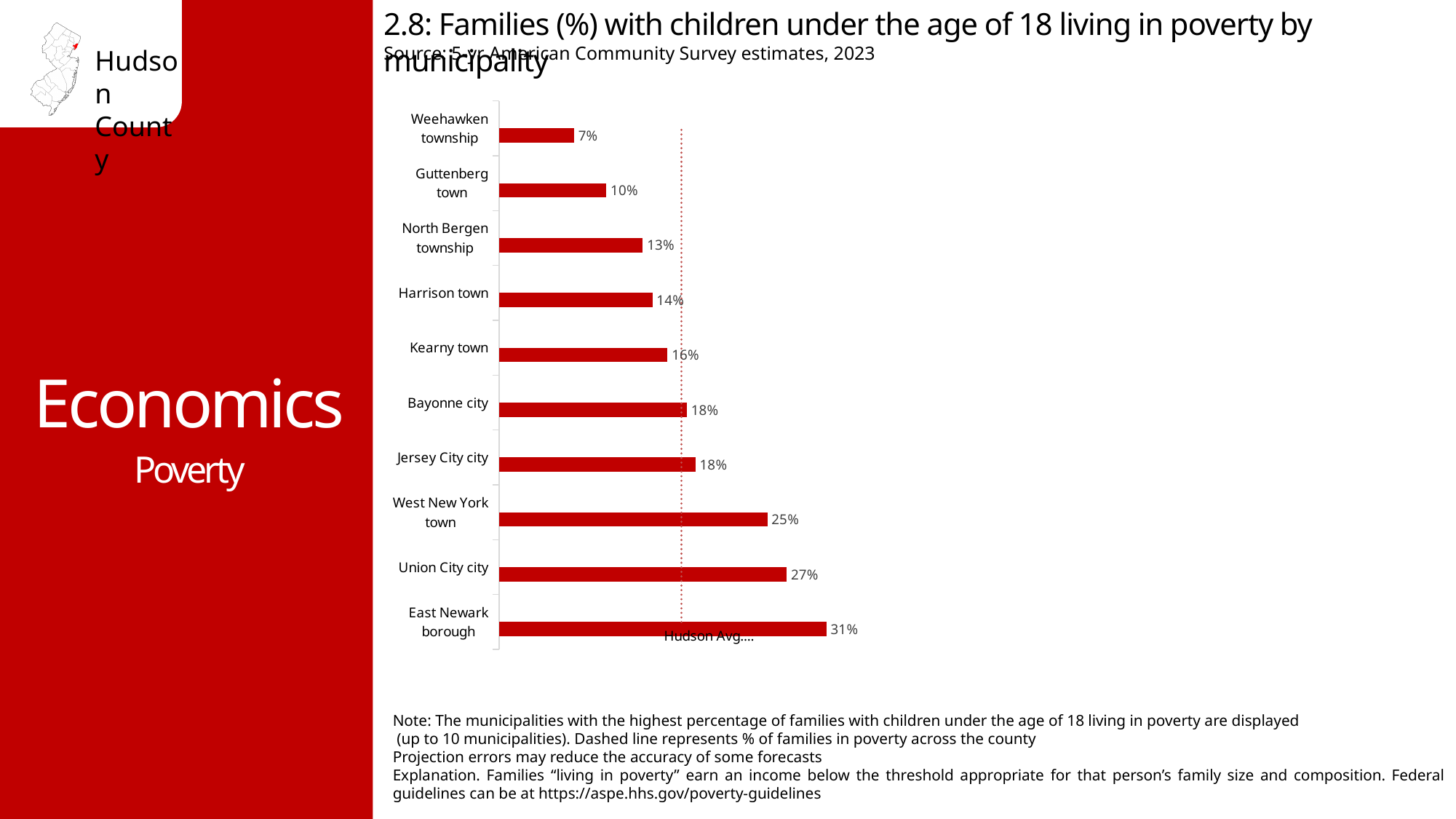
Which municipality has the highest percentage of families with children under 18 living in poverty? East Newark borough What is the value for Weehawken township? 7% What does the dashed vertical line in the chart represent? Hudson Avg. (% of families in poverty across the county) What is the value for West New York town? 25% What kind of chart is shown on the slide? Bar chart What is the value for Kearny town? 16% Which municipality has the lowest percentage of families with children under 18 living in poverty? Weehawken township Which is larger, the value for Harrison town or the value for North Bergen township? Harrison town What is the difference between the values for Union City city and Guttenberg town? 17% What is the value for East Newark borough? 31% How many municipalities are shown in the chart? 10 What is the difference between the values for East Newark borough and Weehawken township? 24%